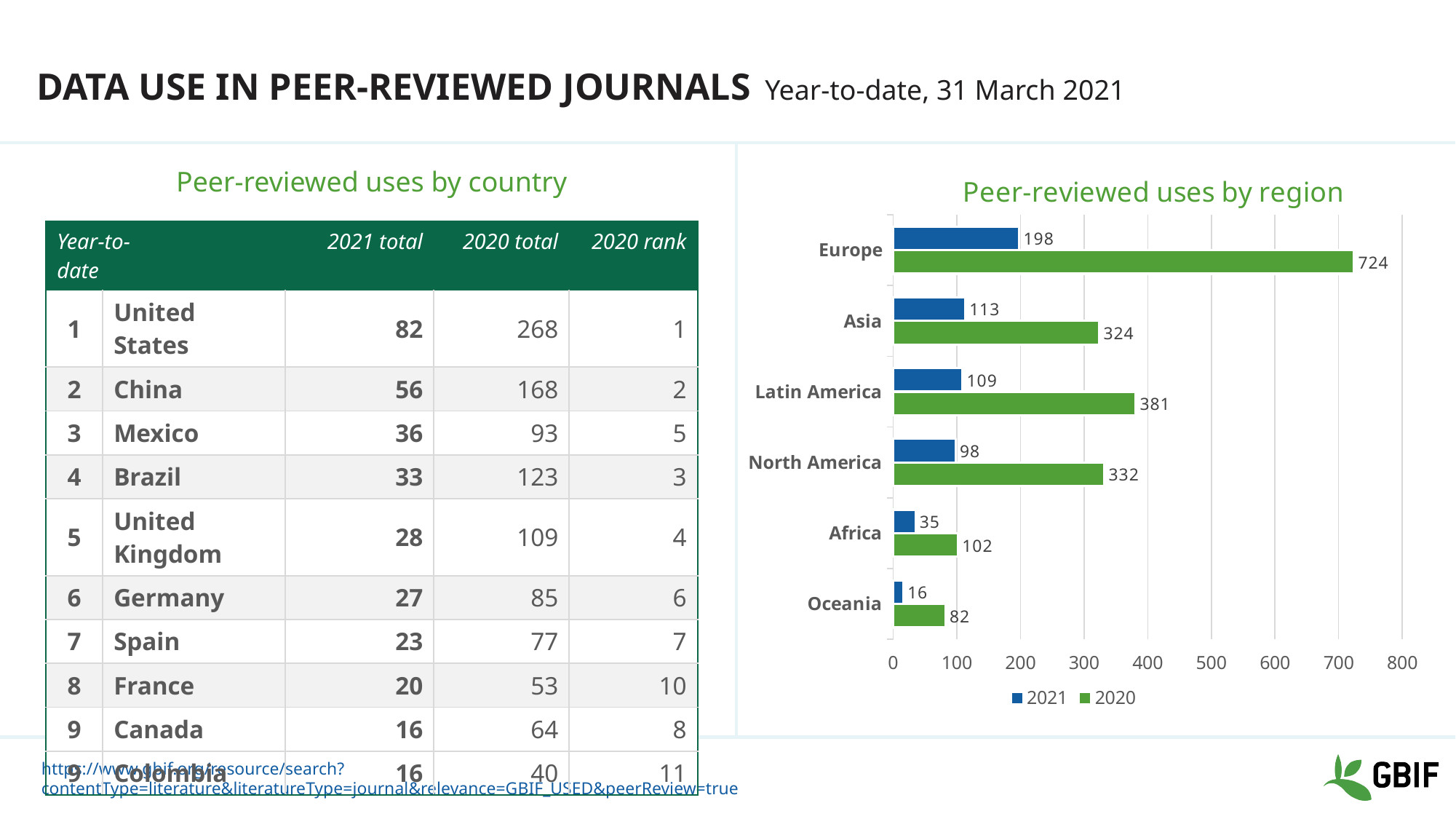
In the 'Peer-reviewed uses by region' chart, is the 2020 value for Africa greater or less than 200? less In the 'Peer-reviewed uses by region' chart, which region has the lowest 2021 value? Oceania How many regions are shown in the 'Peer-reviewed uses by region' chart? 6 In the 'Peer-reviewed uses by region' chart, what is the difference between the 2020 and 2021 values for Asia? 211 What kind of chart is 'Peer-reviewed uses by region'? Bar chart In the 'Peer-reviewed uses by region' chart, what is the 2021 value for Oceania? 16 In the 'Peer-reviewed uses by region' chart, what is the 2021 value for Latin America? 109 In the 'Peer-reviewed uses by region' chart, which colour represents the 2021 series? Blue How many series does the legend of the 'Peer-reviewed uses by region' chart list? 2 In the 'Peer-reviewed uses by region' chart, which is larger for 2020: Latin America or North America? Latin America In the 'Peer-reviewed uses by region' chart, which region has the highest 2020 value? Europe In the 'Peer-reviewed uses by region' chart, what is the 2020 value for Europe? 724